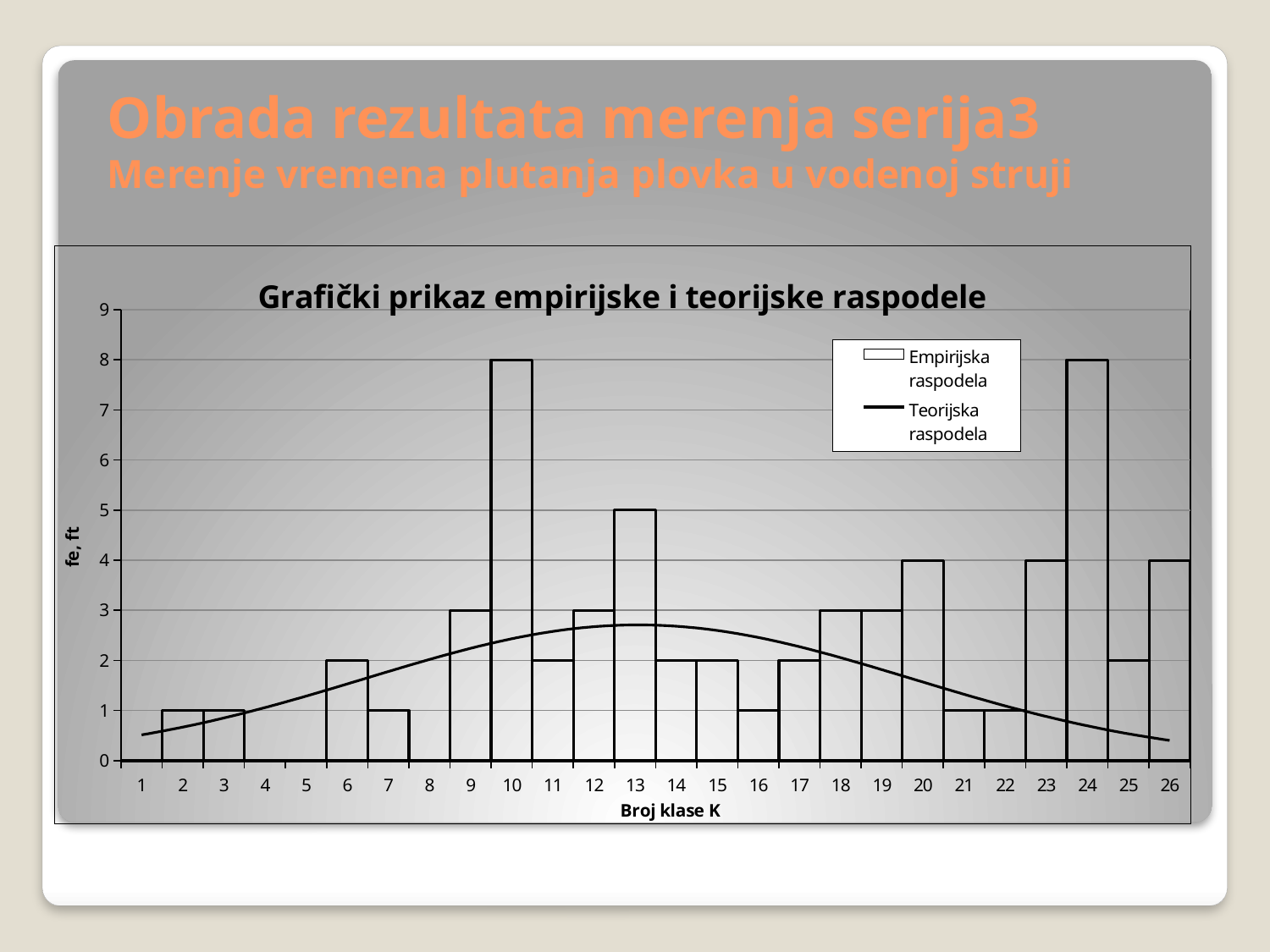
What is the difference between the empirical values for class 10 and class 13? 3 Does the theoretical distribution line rise or fall from class 20 to class 26? fall What are the two entries in the chart legend? Empirijska raspodela, Teorijska raspodela Which has the larger empirical value, class 12 or class 13? class 13 What is the empirical distribution value for class 13? 5 What kind of chart is shown on the slide? bar chart with a line How many classes (Broj klase K) are shown on the x axis? 26 Is the theoretical distribution value at class 13 greater or less than 2? greater What is the title of the chart? Grafički prikaz empirijske i teorijske raspodele What is the empirical distribution value for class 10? 8 What is the empirical distribution value for class 20? 4 How many series does the legend list? 2